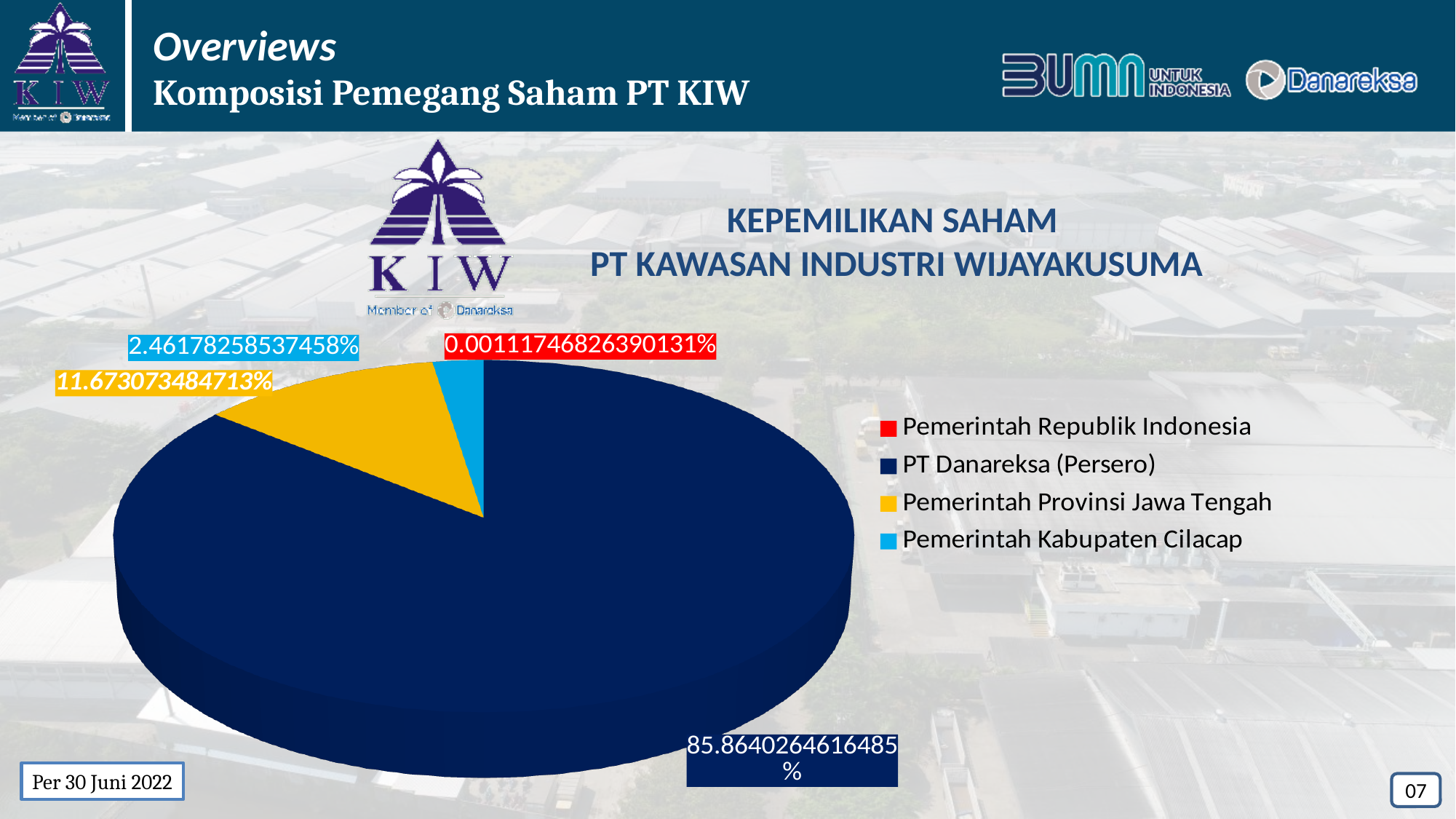
What kind of chart is shown on the slide? Pie chart What is the value shown for Pemerintah Provinsi Jawa Tengah? 11.673073484713% How many entries does the legend list? 4 How many slices does the pie chart have? 4 What is the value shown for Pemerintah Kabupaten Cilacap? 2.46178258537458% Which shareholder has the largest slice of the pie? PT Danareksa (Persero) Which is larger, the share of Pemerintah Provinsi Jawa Tengah or the share of Pemerintah Kabupaten Cilacap? Pemerintah Provinsi Jawa Tengah What is the value shown for Pemerintah Republik Indonesia? 0.00111746826390131% Which colour represents Pemerintah Provinsi Jawa Tengah in the pie chart? Yellow What is the difference between the share of Pemerintah Provinsi Jawa Tengah and the share of Pemerintah Kabupaten Cilacap? 9.21129089933842% What share of the pie does PT Danareksa (Persero) hold? 85.8640264616485% Which shareholder has the smallest slice of the pie? Pemerintah Republik Indonesia